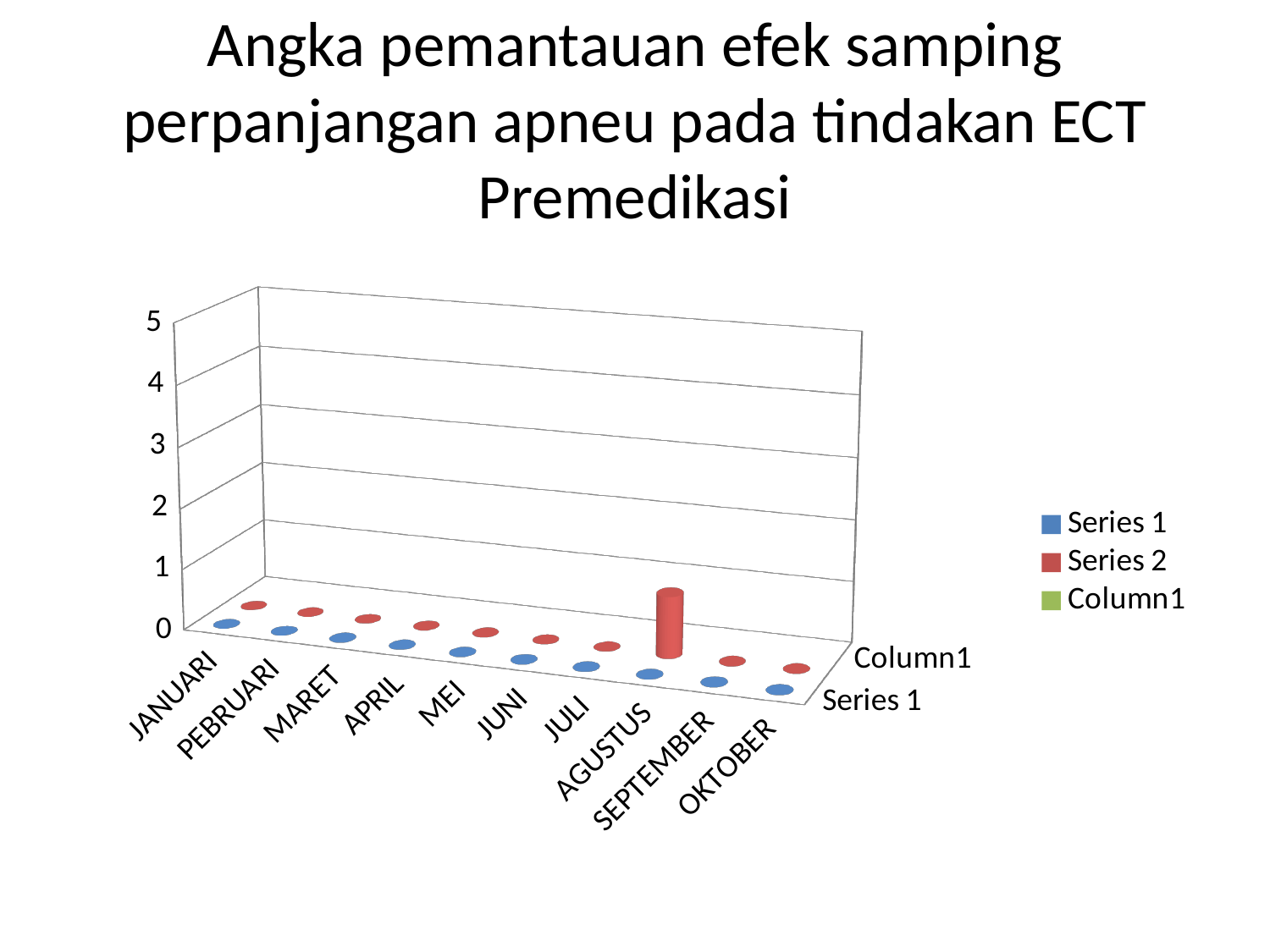
What is the value for Series 1 in JANUARI? 0 What is the value for Series 2 in MARET? 0 How many months are shown along the x axis? 10 What is the highest value shown on the vertical axis? 5 Which is larger, the Series 2 value for AGUSTUS or the Series 2 value for JULI? AGUSTUS What kind of chart is shown on the slide? bar chart How many series does the legend list? 3 Is the Series 2 value for AGUSTUS greater or less than 2? less Which month is the first category on the x axis? JANUARI Which month has the highest value for Series 2? AGUSTUS What are the three entries listed in the legend? Series 1, Series 2, Column1 Which month is the last category on the x axis? OKTOBER